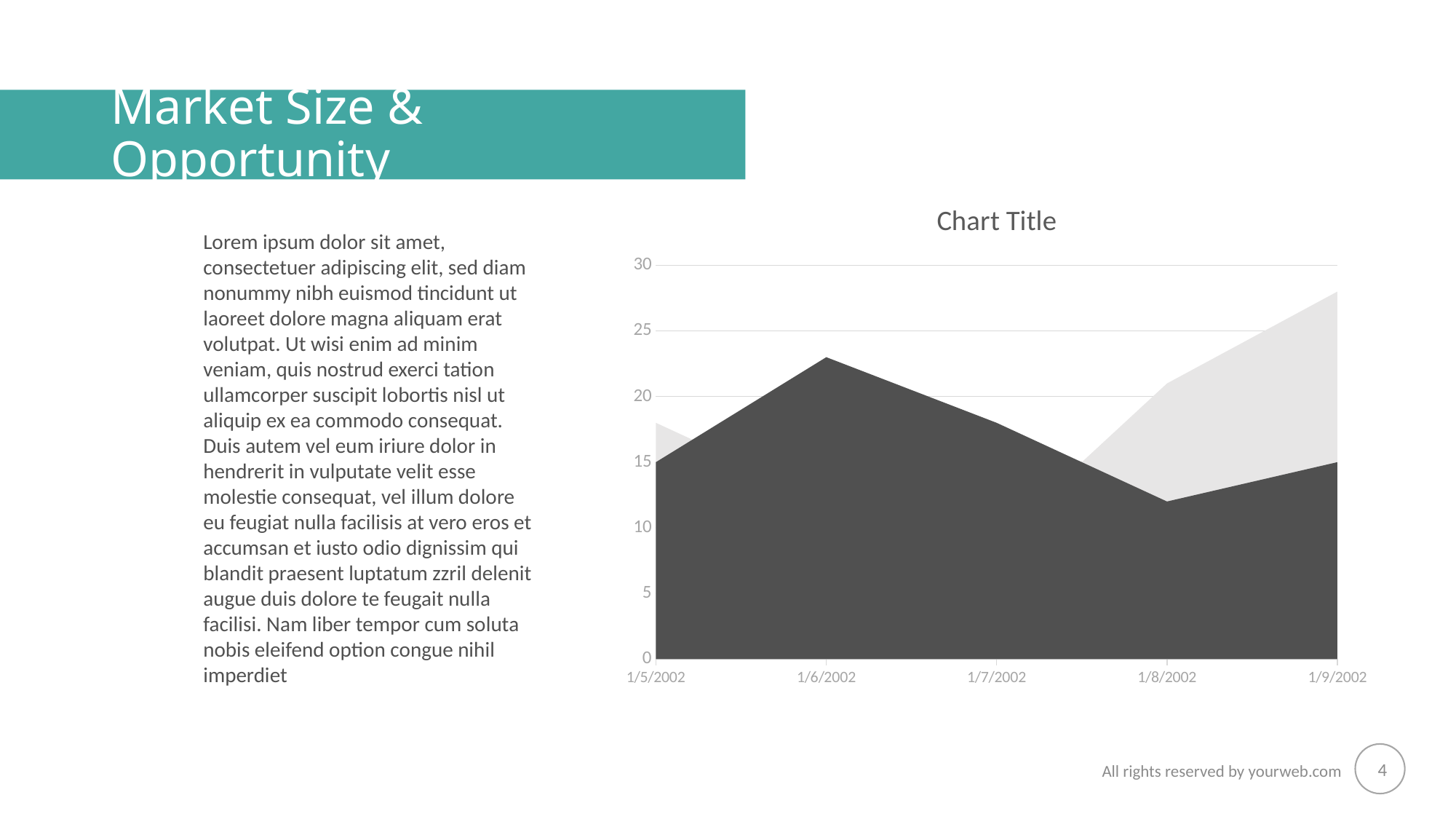
Is the value of the light grey series at 1/9/2002 greater or less than 25? greater Is the value of the dark grey series at 1/6/2002 greater or less than 20? greater On which date does the dark grey series reach its lowest value? 1/8/2002 Does the dark grey series rise or fall from 1/6/2002 to 1/8/2002? fall What kind of chart is shown on the slide? Area chart What is the title of the chart? Chart Title Does the light grey series rise or fall from 1/8/2002 to 1/9/2002? rise Is the value of the dark grey series at 1/8/2002 greater or less than 15? less On which date does the dark grey series reach its highest value? 1/6/2002 How many dates are shown along the x axis of the chart? 5 For the dark grey series, which is larger: the value at 1/6/2002 or the value at 1/7/2002? 1/6/2002 What is the first date label on the x axis of the chart? 1/5/2002